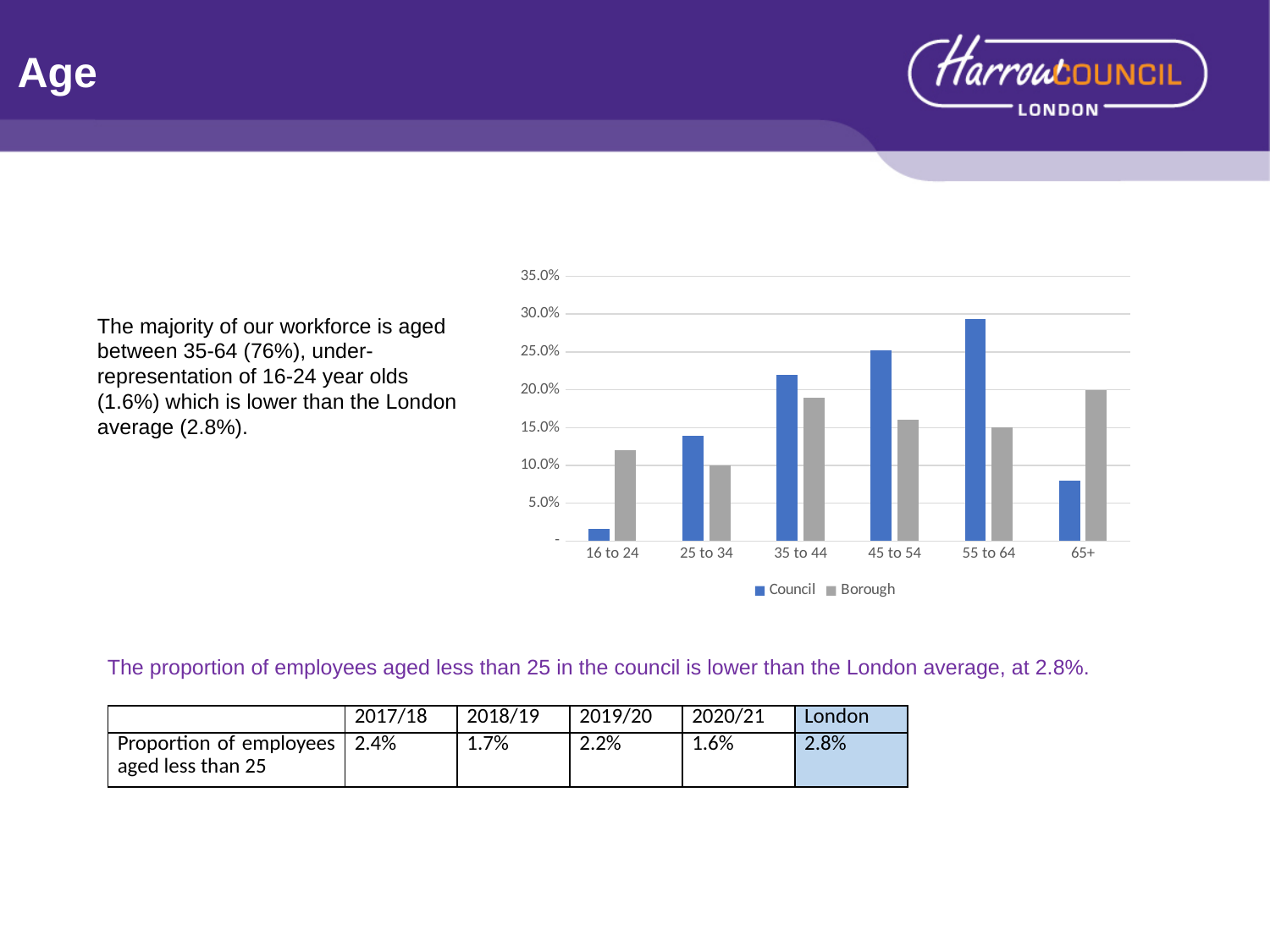
Is the Council value for 55 to 64 greater or less than 25.0%? greater Which age category has the highest Council value? 55 to 64 What kind of chart is shown on the slide? bar chart Which age category has the highest Borough value? 65+ What colour are the Council bars in the chart? blue Is the Borough value for 45 to 54 greater or less than 20.0%? less How many age categories are shown on the x axis of the chart? 6 For the 45 to 54 category, which series has the larger value, Council or Borough? Council Is the Council value for 16 to 24 greater or less than 5.0%? less How many series does the chart legend list? 2 For the 65+ category, which series has the larger value, Council or Borough? Borough Which age category has the lowest Council value? 16 to 24